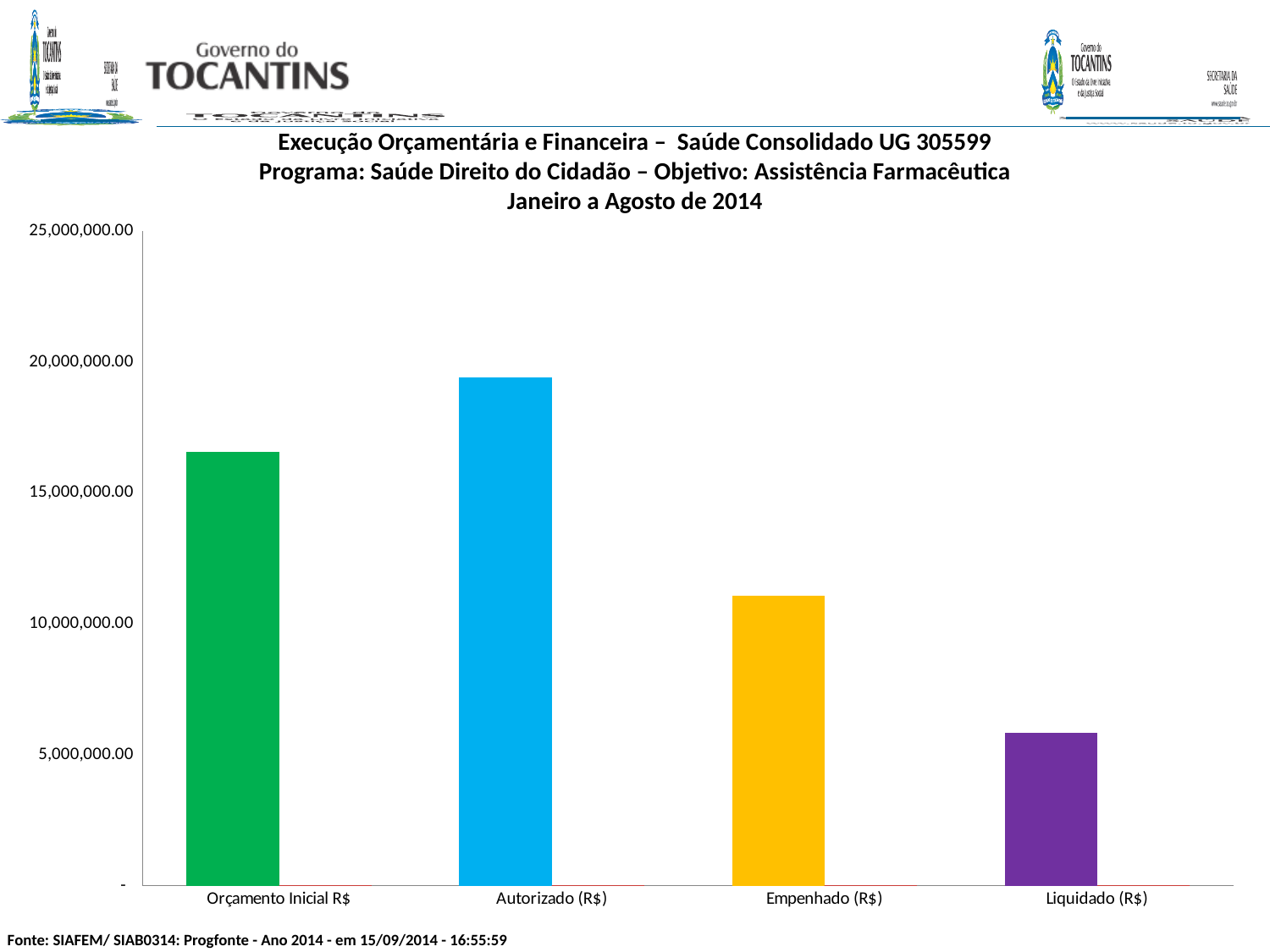
Do the values rise or fall from Autorizado (R$) to Liquidado (R$) along the x axis? fall Which category has the lowest value? Liquidado (R$) Is the value for Empenhado (R$) greater or less than 10,000,000.00? greater How many categories are plotted on the x axis? 4 Which is larger, the value for Orçamento Inicial R$ or the value for Empenhado (R$)? Orçamento Inicial R$ What period does the chart title say the data covers? Janeiro a Agosto de 2014 Which category has the highest value? Autorizado (R$) Is the value for Autorizado (R$) greater or less than 20,000,000.00? less Is the value for Liquidado (R$) greater or less than 5,000,000.00? greater What colour is the bar for Empenhado (R$)? Yellow What kind of chart is shown on the slide? Bar chart